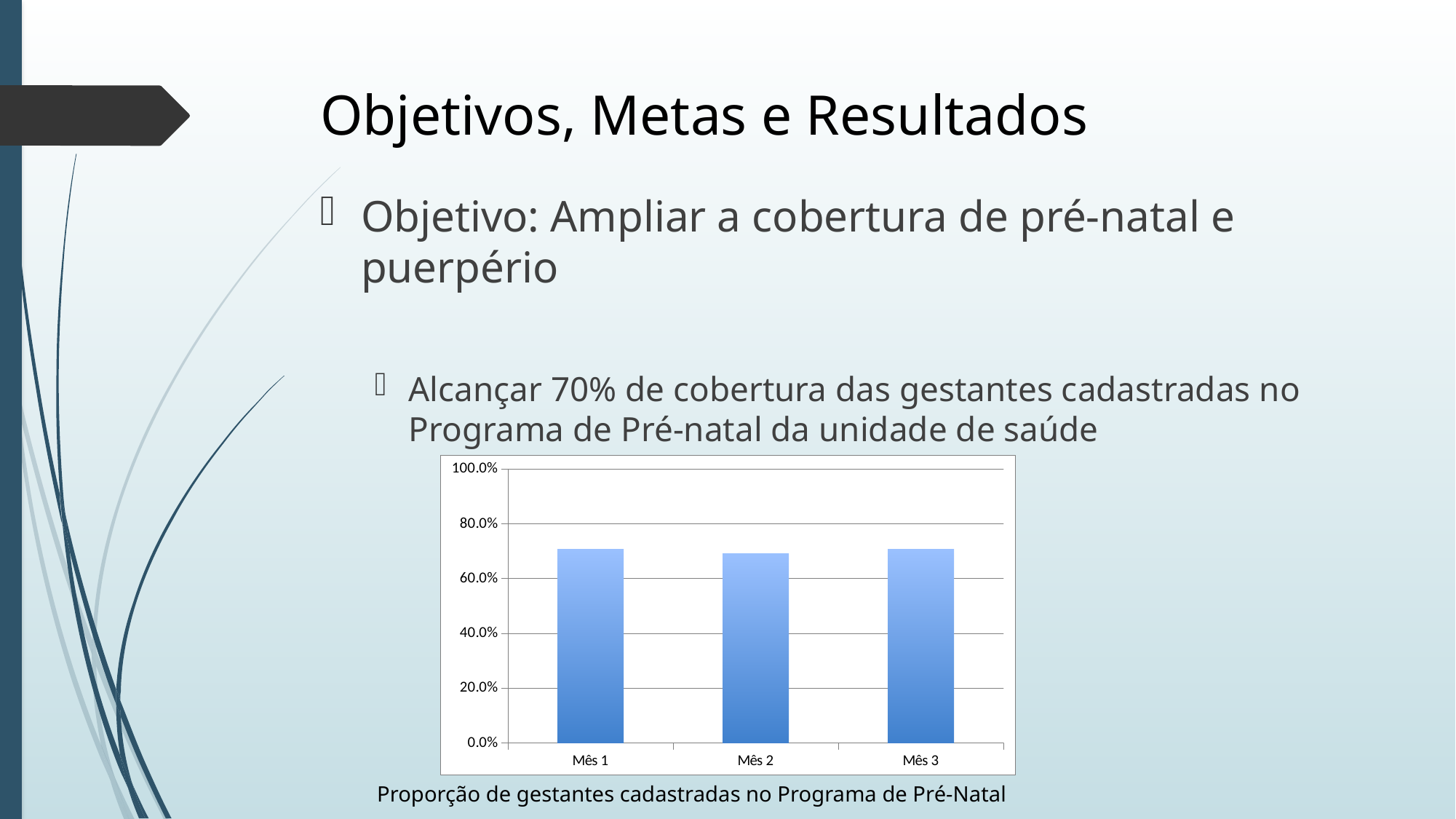
Is the value for Mês 1 greater or less than 60.0%? greater What is the label of the first category on the x axis? Mês 1 Is the value for Mês 2 greater or less than 40.0%? greater Is the value for Mês 1 greater or less than 80.0%? less How many categories are shown on the x axis of the chart? 3 What is the highest value shown on the y axis of the chart? 100.0% What kind of chart is shown on the slide? bar chart What is the caption printed below the chart? Proporção de gestantes cadastradas no Programa de Pré-Natal